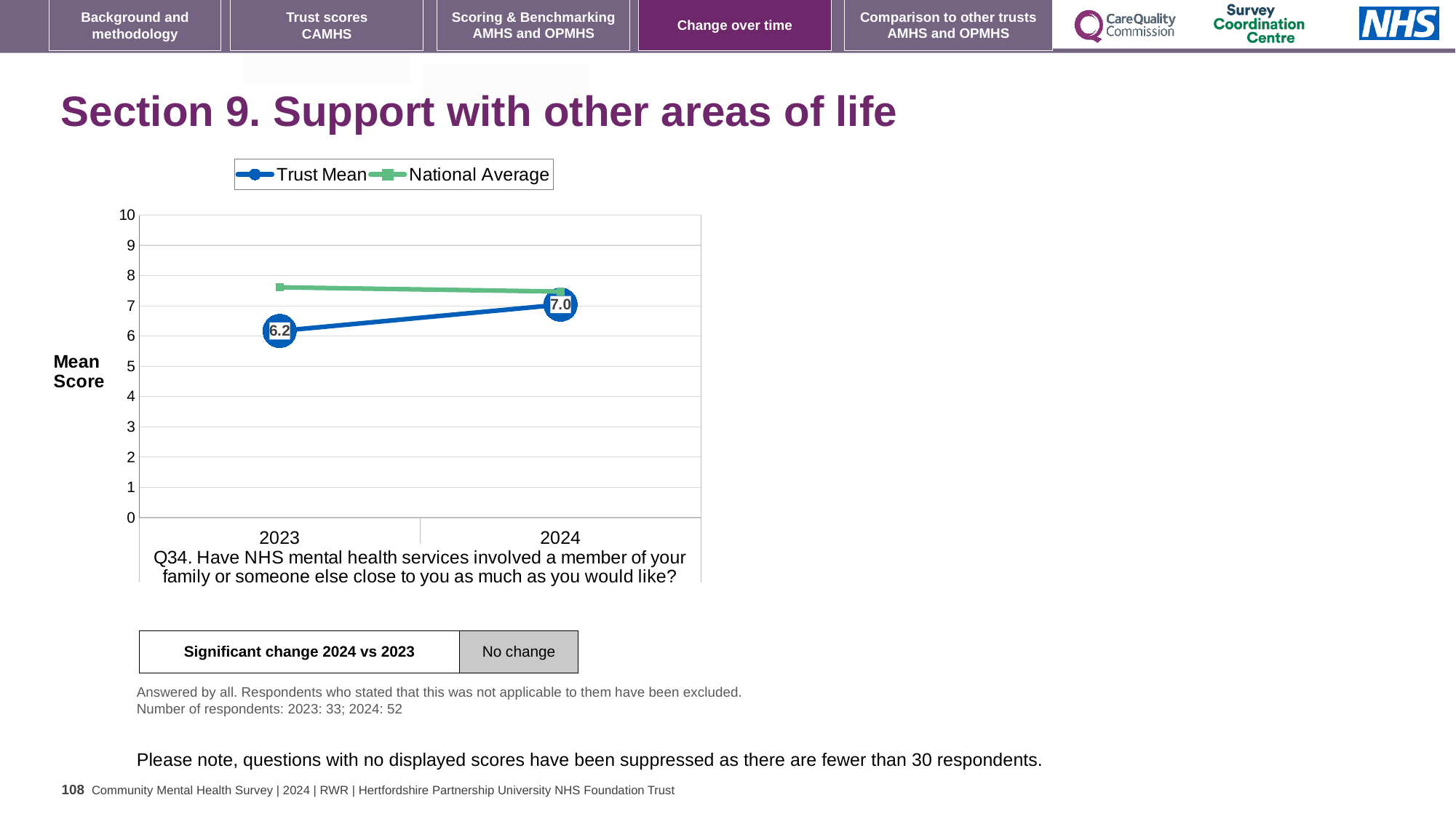
Which year has the higher Trust Mean score, 2023 or 2024? 2024 What is the label on the y axis of the chart? Mean Score How many years are plotted on the x axis? 2 By how much did the Trust Mean score change from 2023 to 2024? 0.8 How many series does the legend list? 2 What is the Trust Mean score for 2023? 6.2 What type of chart is shown on the slide? line chart Does the Trust Mean line rise or fall from 2023 to 2024? rise What is the Trust Mean score for 2024? 7.0 In 2023, which is higher, the Trust Mean or the National Average? National Average Is the National Average value for 2023 greater or less than 7? greater In which year is the Trust Mean score lowest? 2023